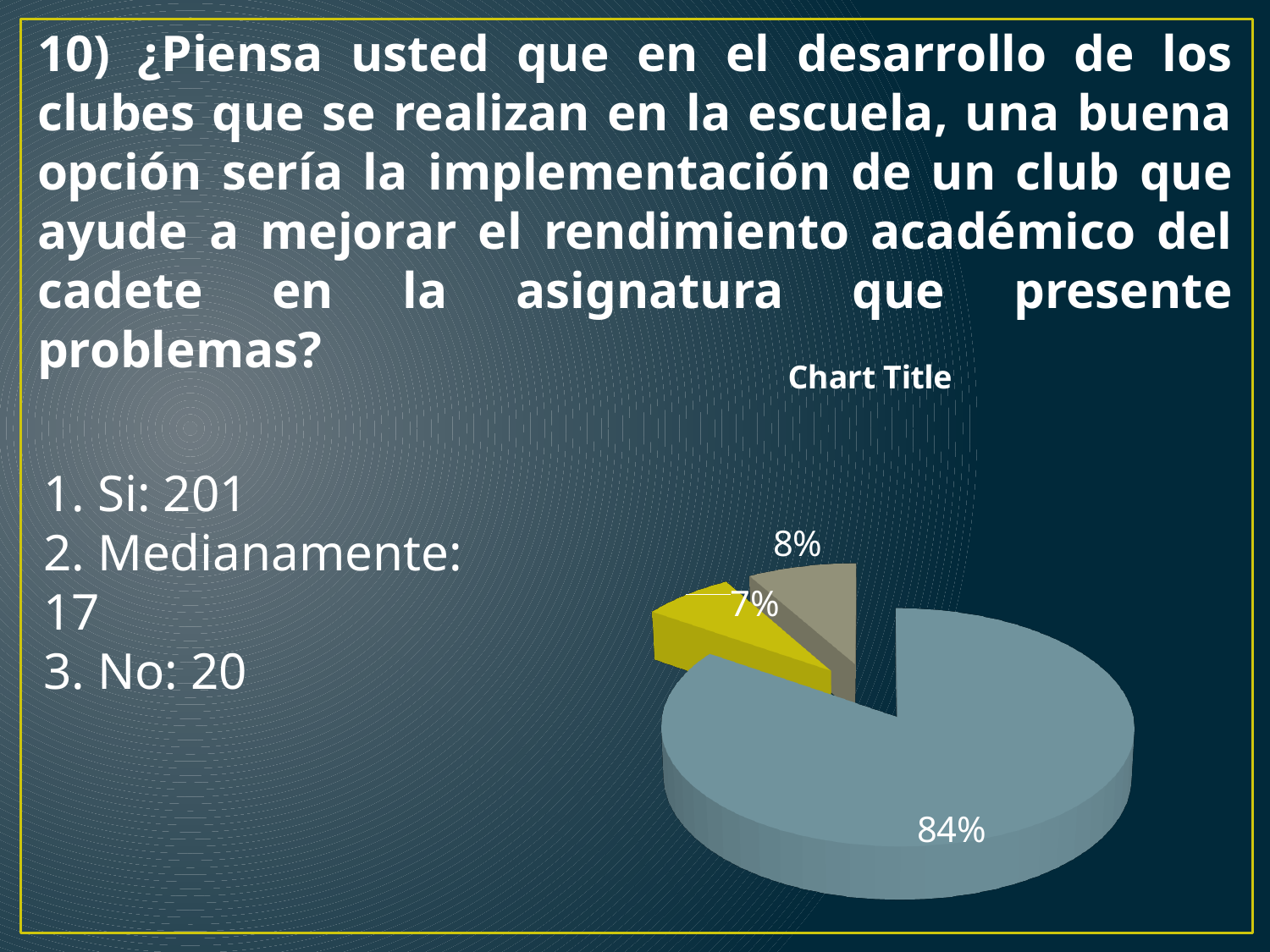
What colour is the largest slice of the pie chart? blue-grey What percentage is shown on the tan (beige) slice of the pie chart? 8% What percentage is shown on the blue-grey slice of the pie chart? 84% How many slices does the pie chart have? 3 What percentage is shown on the yellow slice of the pie chart? 7% What kind of chart is shown on the slide? pie chart Is the share of the largest slice greater or less than 50%? greater What is the title of the chart? Chart Title What is the difference in percentage points between the largest slice (84%) and the slice labelled 8%? 76 What percentage is shown on the largest slice of the pie chart? 84% Which is larger, the slice labelled 8% or the slice labelled 7%? the slice labelled 8% What percentage is shown on the smallest slice of the pie chart? 7%